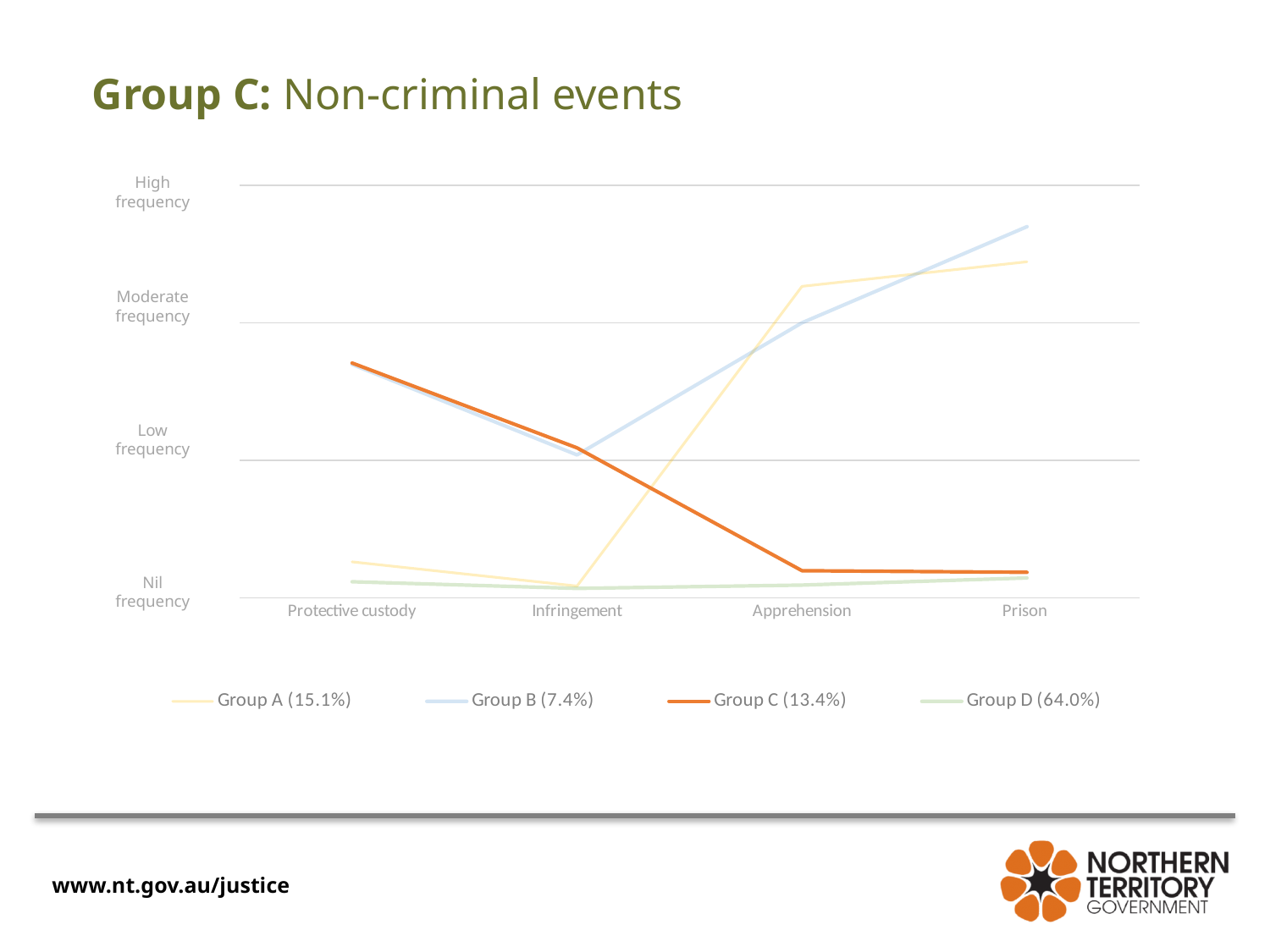
For Group C, which is higher: the value at Protective custody or the value at Prison? Protective custody What is the title of the slide? Group C: Non-criminal events What percentage is shown in the legend for Group D? 64.0% What kind of chart is shown on the slide? line chart Which group has the highest value at Protective custody? Group C Which group has the highest value at Prison? Group B How many categories are shown on the x axis? 4 Does the Group B line rise or fall from Infringement to Prison? rise Which group has the highest value at Apprehension? Group A Does the Group C line rise or fall from Protective custody to Prison? fall How many series does the legend list? 4 At Apprehension, which is higher: Group A or Group B? Group A